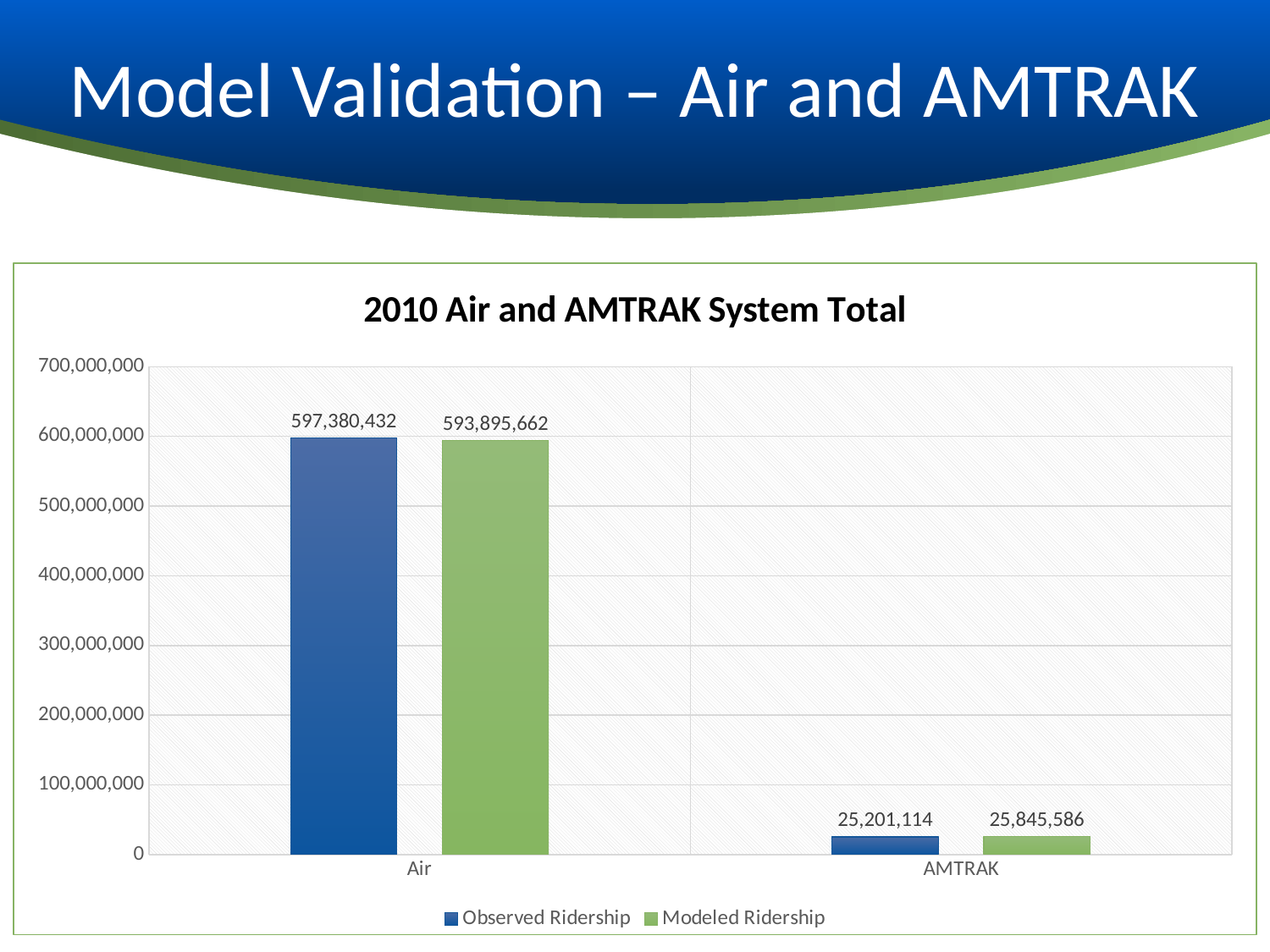
Which category has the higher Observed Ridership, Air or AMTRAK? Air Is the Observed Ridership value for Air greater or less than 500,000,000? greater Which category has the lowest Modeled Ridership? AMTRAK What is the difference between Modeled Ridership and Observed Ridership for AMTRAK? 644,472 What is the Modeled Ridership value for Air? 593,895,662 How many series does the legend list? 2 For AMTRAK, which is larger, Observed Ridership or Modeled Ridership? Modeled Ridership What is the Observed Ridership value for AMTRAK? 25,201,114 What is the difference between Observed Ridership and Modeled Ridership for Air? 3,484,770 What is the title of the chart? 2010 Air and AMTRAK System Total What is the Observed Ridership value for Air? 597,380,432 What is the Modeled Ridership value for AMTRAK? 25,845,586